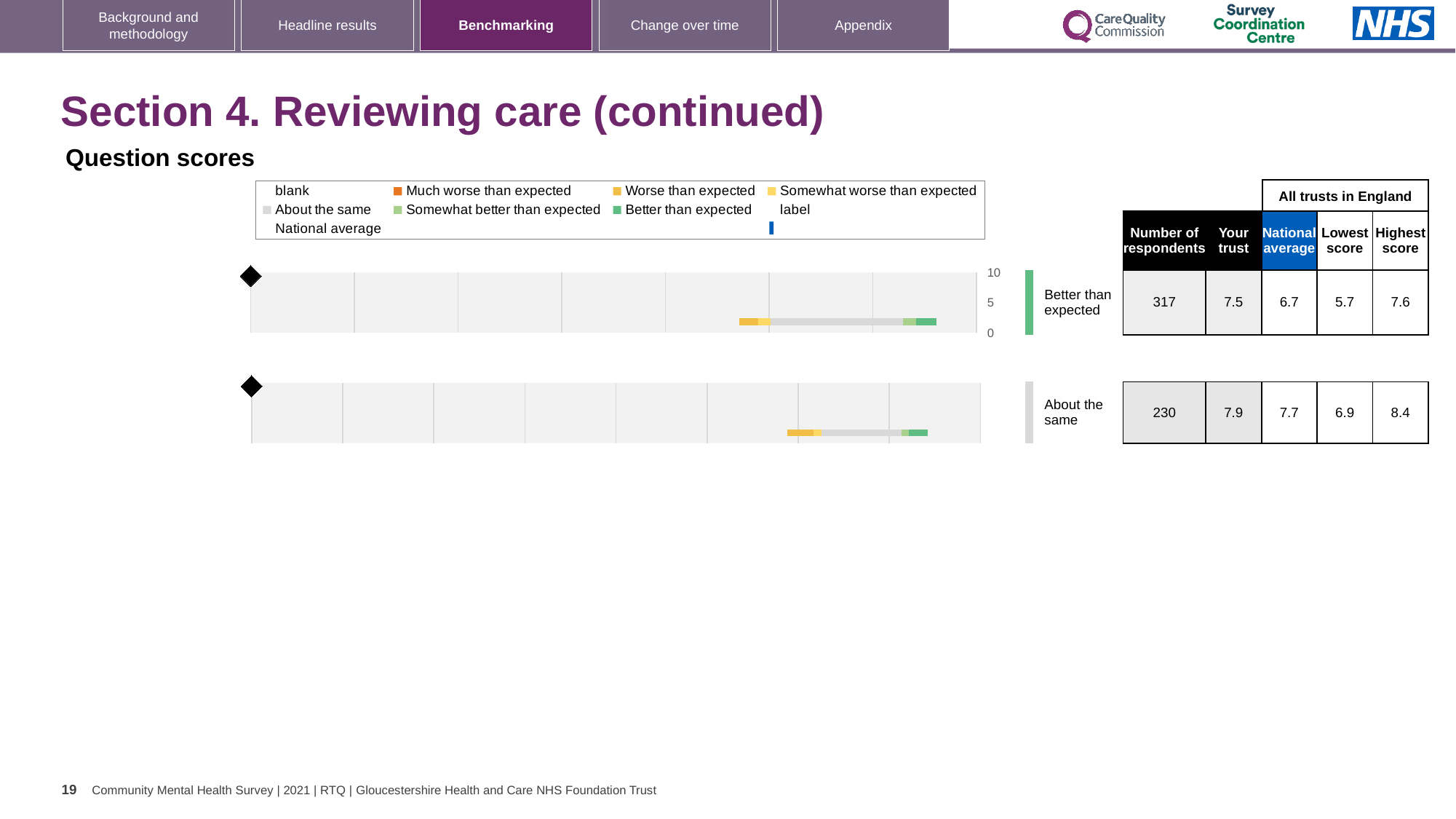
How many question score bars (rows) are shown on the slide? 2 For the top chart row, labelled 'Better than expected', which is larger: the 'Your trust' score or the national average? Your trust For the bottom chart row, labelled 'About the same', what is the 'Your trust' score? 7.9 For the bottom chart row, labelled 'About the same', what is the highest score among all trusts in England? 8.4 For the top chart row, labelled 'Better than expected', how many respondents are there? 317 For the bottom chart row, labelled 'About the same', what is the difference between the highest score and the lowest score? 1.5 What kind of chart is used to show the question scores on this slide? bar chart For the top chart row, labelled 'Better than expected', what is the national average score? 6.7 For the top chart row, labelled 'Better than expected', what is the 'Your trust' score? 7.5 In the legend, what colour represents 'Better than expected'? green Which of the two chart rows has the higher 'Your trust' score? About the same For the top chart row, labelled 'Better than expected', what is the difference between the 'Your trust' score and the national average? 0.8